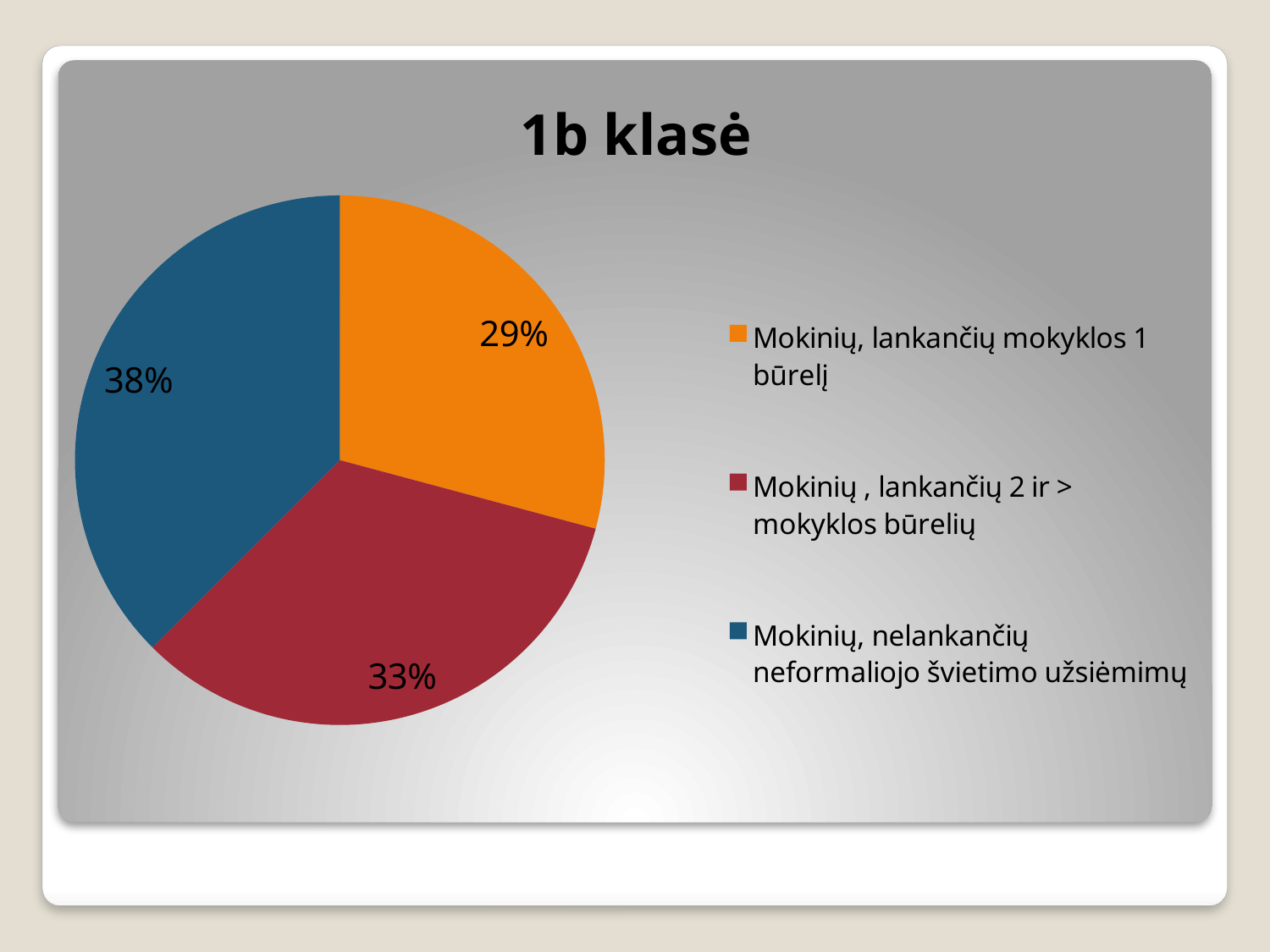
What kind of chart is shown on the slide? pie chart How many slices does the pie have? 3 What share of the pie is 'Mokinių, lankančių 2 ir > mokyklos būrelių'? 33% What colour is the slice for 'Mokinių, nelankančių neformaliojo švietimo užsiėmimų'? blue Which category has the smallest slice? Mokinių, lankančių mokyklos 1 būrelį Which category has the largest slice? Mokinių, nelankančių neformaliojo švietimo užsiėmimų What is the chart's title? 1b klasė What share of the pie is 'Mokinių, lankančių mokyklos 1 būrelį'? 29% How many entries does the legend list? 3 What share of the pie is 'Mokinių, nelankančių neformaliojo švietimo užsiėmimų'? 38% What is the difference in percentage points between 'Mokinių, nelankančių neformaliojo švietimo užsiėmimų' and 'Mokinių, lankančių mokyklos 1 būrelį'? 9 percentage points Which is larger: the slice for 'Mokinių, lankančių 2 ir > mokyklos būrelių' or the slice for 'Mokinių, lankančių mokyklos 1 būrelį'? Mokinių, lankančių 2 ir > mokyklos būrelių